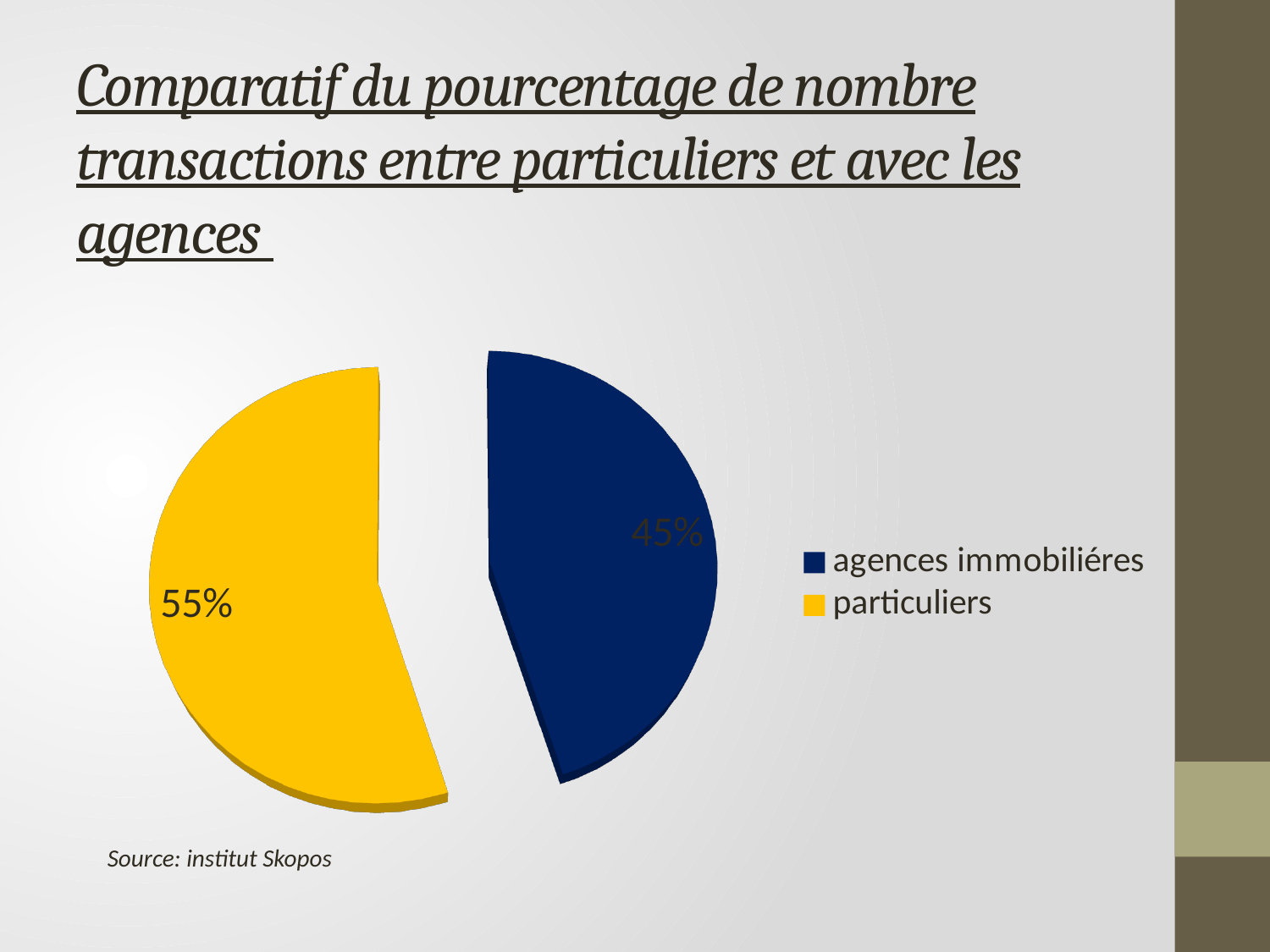
What is the difference in percentage points between the particuliers slice and the agences immobiliéres slice? 10 Which slice of the pie is the largest? particuliers How many entries does the legend list? 2 What colour is the particuliers slice in the pie chart? yellow How many slices does the pie chart have? 2 What kind of chart is shown on the slide? pie chart Which slice of the pie is the smallest? agences immobiliéres What share of the pie does the agences immobiliéres slice represent? 45% Which is larger, the share for particuliers or the share for agences immobiliéres? particuliers What source is cited below the chart? institut Skopos What percentage of the pie is labelled for agences immobiliéres? 45% What percentage of the pie is labelled for particuliers? 55%